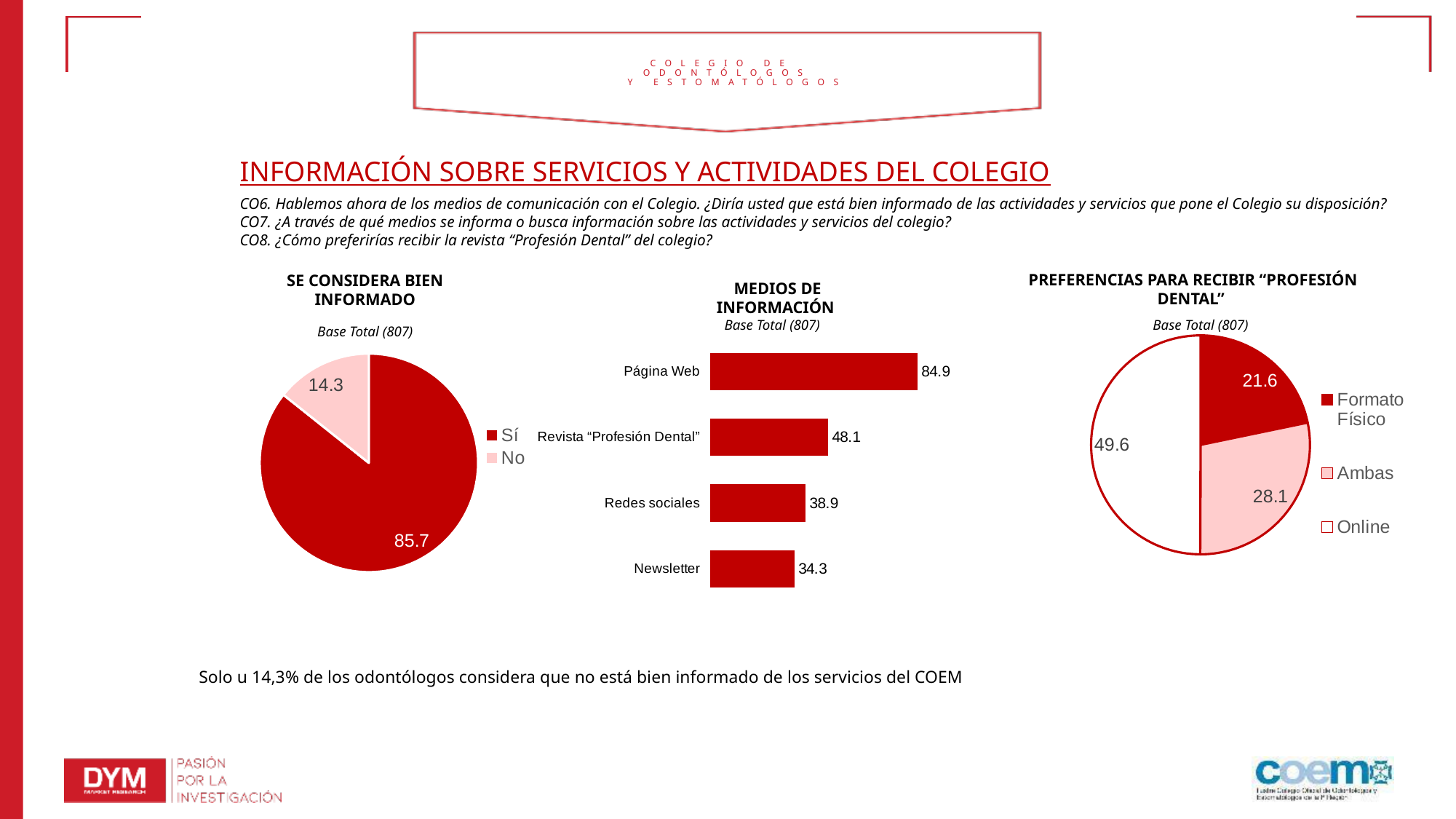
In the "MEDIOS DE INFORMACIÓN" chart, what kind of chart is shown? Bar chart In the "PREFERENCIAS PARA RECIBIR 'PROFESIÓN DENTAL'" pie chart, which is larger, Formato Físico or Ambas? Ambas In the "MEDIOS DE INFORMACIÓN" chart, how many categories are shown? 4 In the "MEDIOS DE INFORMACIÓN" chart, what is the value for Redes sociales? 38.9 In the "SE CONSIDERA BIEN INFORMADO" pie chart, what is the value for Sí? 85.7 In the "SE CONSIDERA BIEN INFORMADO" pie chart, what is the value for No? 14.3 In the "PREFERENCIAS PARA RECIBIR 'PROFESIÓN DENTAL'" pie chart, what is the value for Online? 49.6 In the "MEDIOS DE INFORMACIÓN" chart, what is the difference between Página Web and Revista "Profesión Dental"? 36.8 In the "MEDIOS DE INFORMACIÓN" chart, what is the value for Página Web? 84.9 In the "SE CONSIDERA BIEN INFORMADO" pie chart, what kind of chart is shown? Pie chart In the "MEDIOS DE INFORMACIÓN" chart, which category has the lowest value? Newsletter In the "MEDIOS DE INFORMACIÓN" chart, which category has the highest value? Página Web